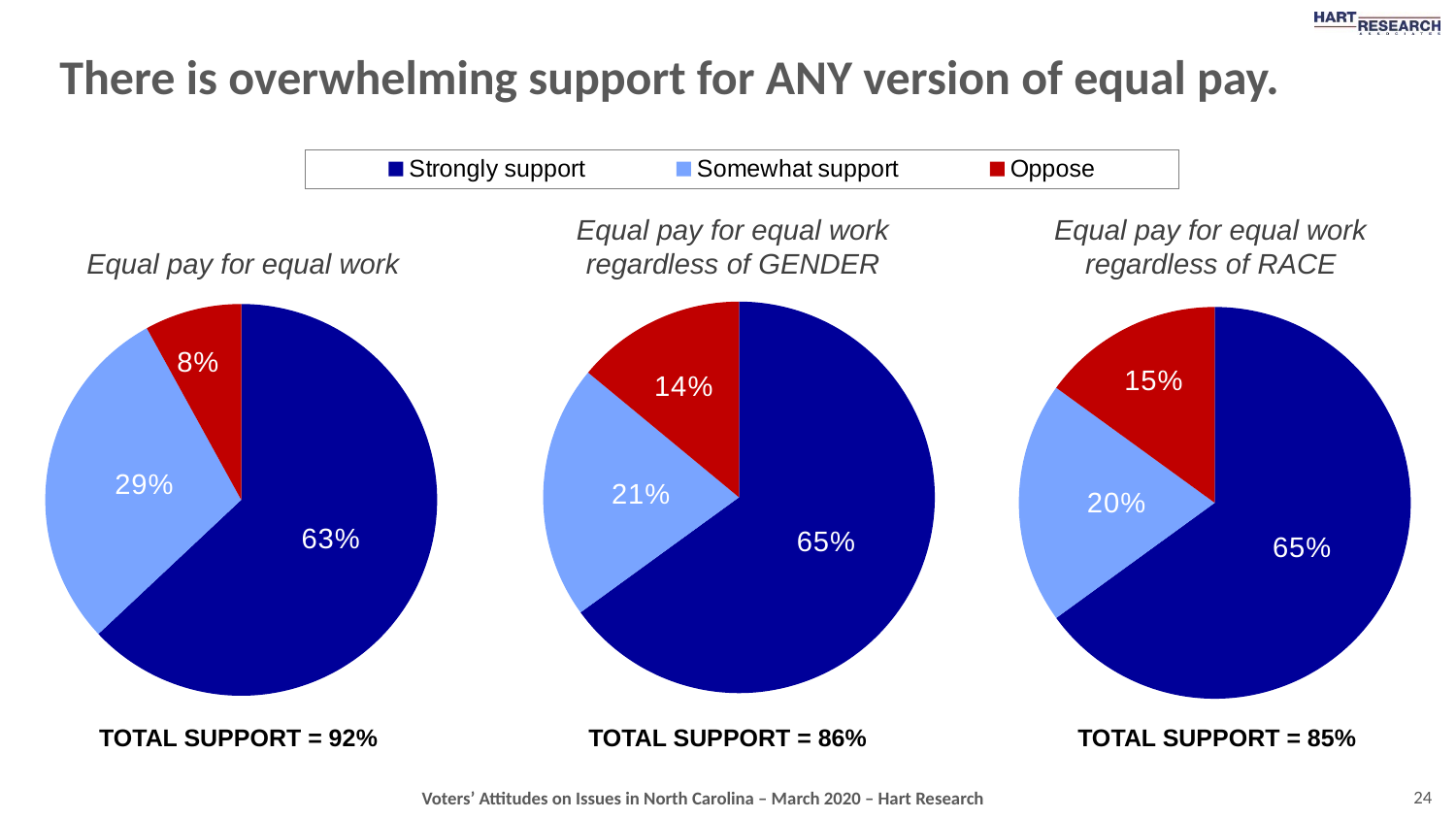
What type of chart is used on this slide? Pie chart In the 'Equal pay for equal work regardless of GENDER' pie chart, what is the difference between the strongly support and somewhat support shares? 44% What is the total support shown below the 'Equal pay for equal work regardless of GENDER' chart? 86% What colour represents 'Oppose' in the legend? Red In the 'Equal pay for equal work' pie chart, which response has the smallest share? Oppose How many pie charts are shown on the slide? 3 How many series does the legend list? 3 In the 'Equal pay for equal work regardless of RACE' pie chart, what percentage somewhat support? 20% In the 'Equal pay for equal work regardless of RACE' pie chart, which response has the largest share? Strongly support In the 'Equal pay for equal work' pie chart, what percentage strongly support? 63% Is the oppose share larger in the 'Equal pay for equal work' chart or the 'Equal pay for equal work regardless of RACE' chart? Equal pay for equal work regardless of RACE In the 'Equal pay for equal work regardless of GENDER' pie chart, what percentage oppose? 14%